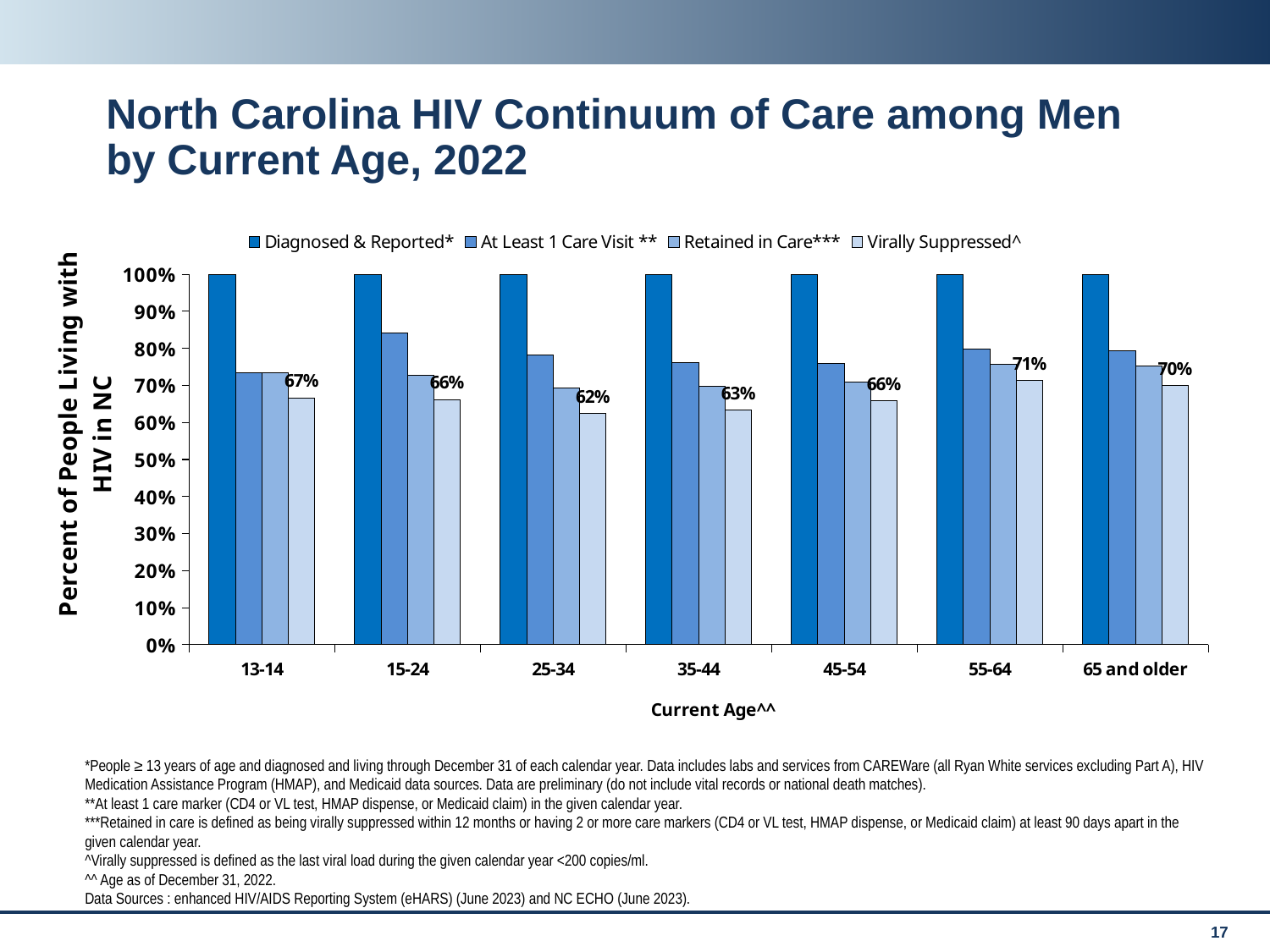
What kind of chart is shown on the slide? Bar chart Is the At Least 1 Care Visit ** value for the 35-44 age group greater or less than 80%? less Is the At Least 1 Care Visit ** value for the 15-24 age group greater or less than 80%? greater What is the Virally Suppressed^ value for the 55-64 age group? 71% What is the difference between the Virally Suppressed^ values for the 55-64 and 25-34 age groups? 9 percentage points What is the Diagnosed & Reported* value for the 35-44 age group? 100% Which age group has the highest Virally Suppressed^ value? 55-64 How many age groups are shown on the x axis? 7 What is the Virally Suppressed^ value for the 25-34 age group? 62% Which age group has the lowest Virally Suppressed^ value? 25-34 Which age group has a higher Virally Suppressed^ value, 35-44 or 65 and older? 65 and older How many series does the legend list? 4